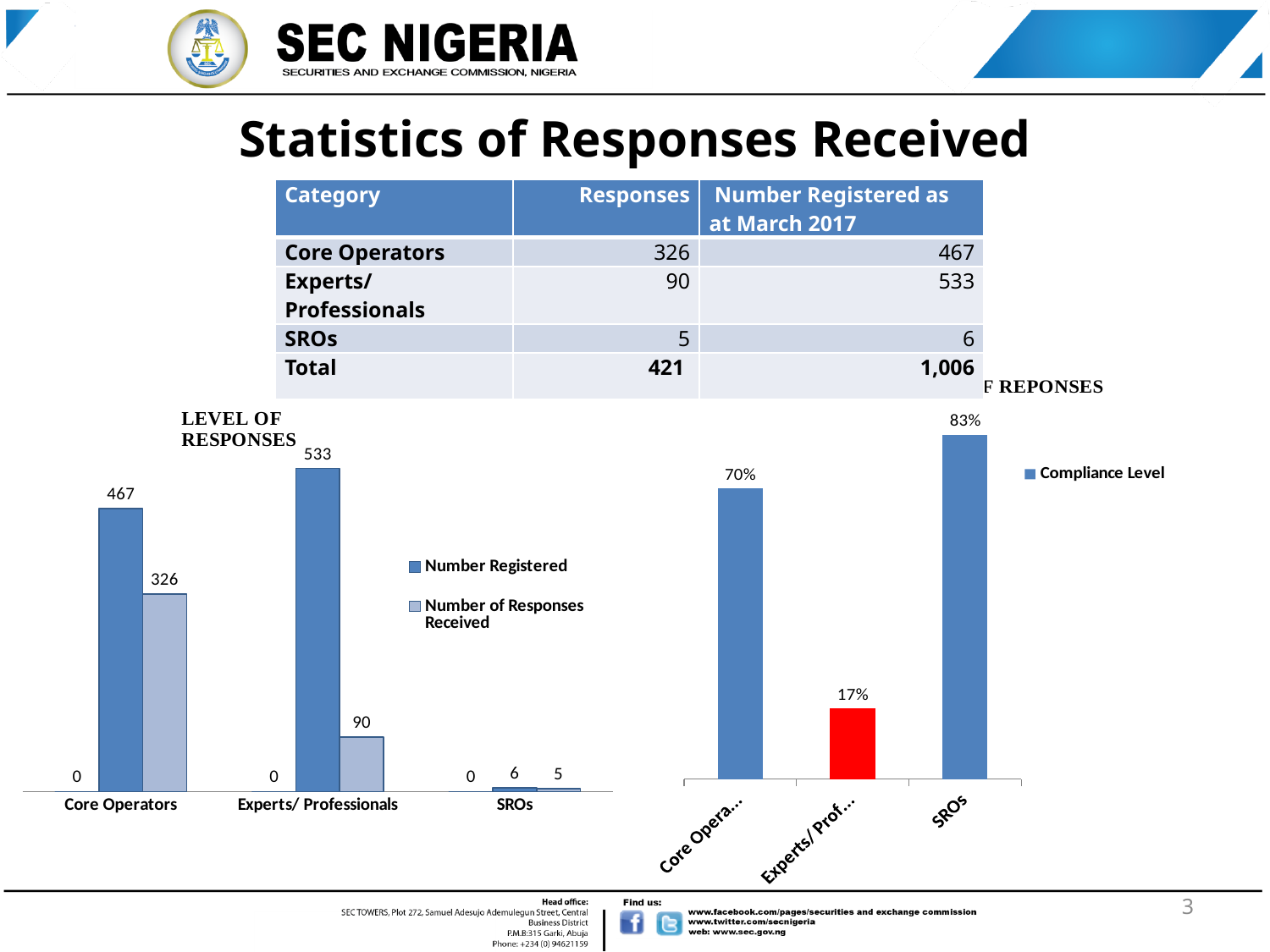
In the LEVEL OF RESPONSES chart, what is the Number Registered for Core Operators? 467 In the LEVEL OF RESPONSES chart, which category has the highest Number Registered? Experts/ Professionals In the LEVEL OF RESPONSES chart, what is the difference between Number Registered and Number of Responses Received for Core Operators? 141 In the Compliance Level chart on the right, what is the difference between the values for SROs and Core Operators? 13% In the LEVEL OF RESPONSES chart, which is larger for Experts/ Professionals: Number Registered or Number of Responses Received? Number Registered In the Compliance Level chart on the right, what is the value for SROs? 83% How many series does the legend of the LEVEL OF RESPONSES chart list? 2 In the LEVEL OF RESPONSES chart, which category has the lowest Number of Responses Received? SROs In the Compliance Level chart on the right, which category has the lowest compliance level? Experts/ Professionals What kind of chart is the LEVEL OF RESPONSES chart? Bar chart In the LEVEL OF RESPONSES chart, what is the Number Registered for SROs? 6 In the LEVEL OF RESPONSES chart, what is the Number of Responses Received for Experts/ Professionals? 90